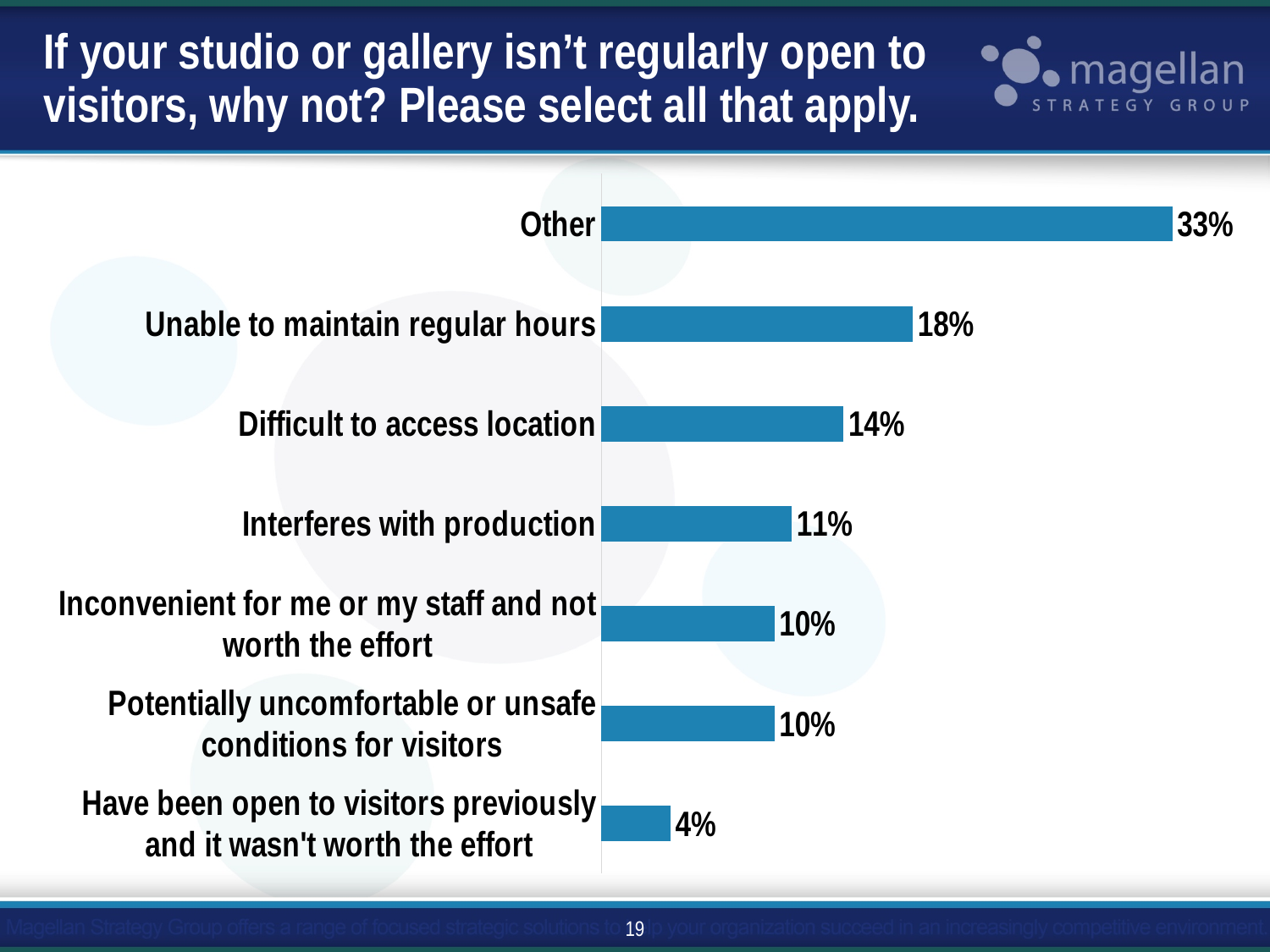
Which is larger: the value for "Difficult to access location" or the value for "Interferes with production"? Difficult to access location What percentage of respondents selected "Unable to maintain regular hours"? 18% What is the difference in percentage points between "Other" and "Unable to maintain regular hours"? 15 What percentage of respondents selected "Difficult to access location"? 14% What percentage of respondents selected "Have been open to visitors previously and it wasn't worth the effort"? 4% What percentage of respondents selected "Other"? 33% What kind of chart is shown on the slide? Bar chart Which reason has the highest percentage? Other How many reasons (categories) are shown in the chart? 7 What percentage of respondents selected "Interferes with production"? 11% What is the difference in percentage points between "Inconvenient for me or my staff and not worth the effort" and "Potentially uncomfortable or unsafe conditions for visitors"? 0 Which reason has the lowest percentage? Have been open to visitors previously and it wasn't worth the effort